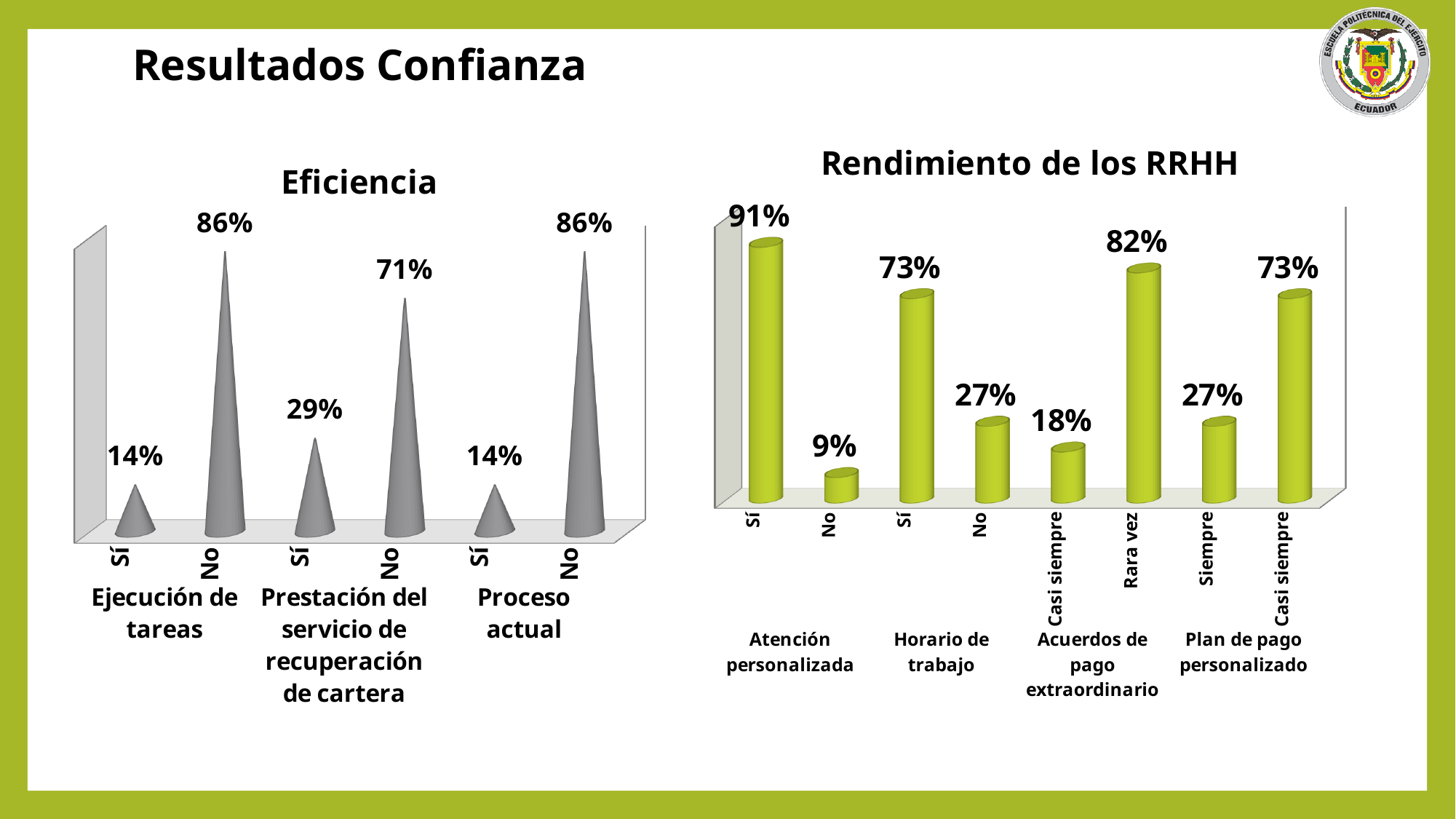
In the 'Rendimiento de los RRHH' chart, which is larger: 'Siempre' or 'Casi siempre' under 'Plan de pago personalizado'? Casi siempre In the 'Eficiencia' chart, what is the value for 'No' under 'Ejecución de tareas'? 86% In the 'Eficiencia' chart, what is the difference between 'No' and 'Sí' under 'Proceso actual'? 72% In the 'Rendimiento de los RRHH' chart, which bar has the lowest value? No (Atención personalizada), 9% In the 'Rendimiento de los RRHH' chart, how many bars are plotted? 8 In the 'Eficiencia' chart, how many bars are plotted? 6 In the 'Eficiencia' chart, what is the value for 'Sí' under 'Prestación del servicio de recuperación de cartera'? 29% In the 'Rendimiento de los RRHH' chart, what is the value for 'Sí' under 'Atención personalizada'? 91% In the 'Eficiencia' chart, which group has the highest 'Sí' value? Prestación del servicio de recuperación de cartera In the 'Rendimiento de los RRHH' chart, what is the difference between 'Sí' and 'No' under 'Horario de trabajo'? 46% What type of chart is 'Rendimiento de los RRHH'? Bar chart In the 'Rendimiento de los RRHH' chart, what is the value for 'Rara vez' under 'Acuerdos de pago extraordinario'? 82%